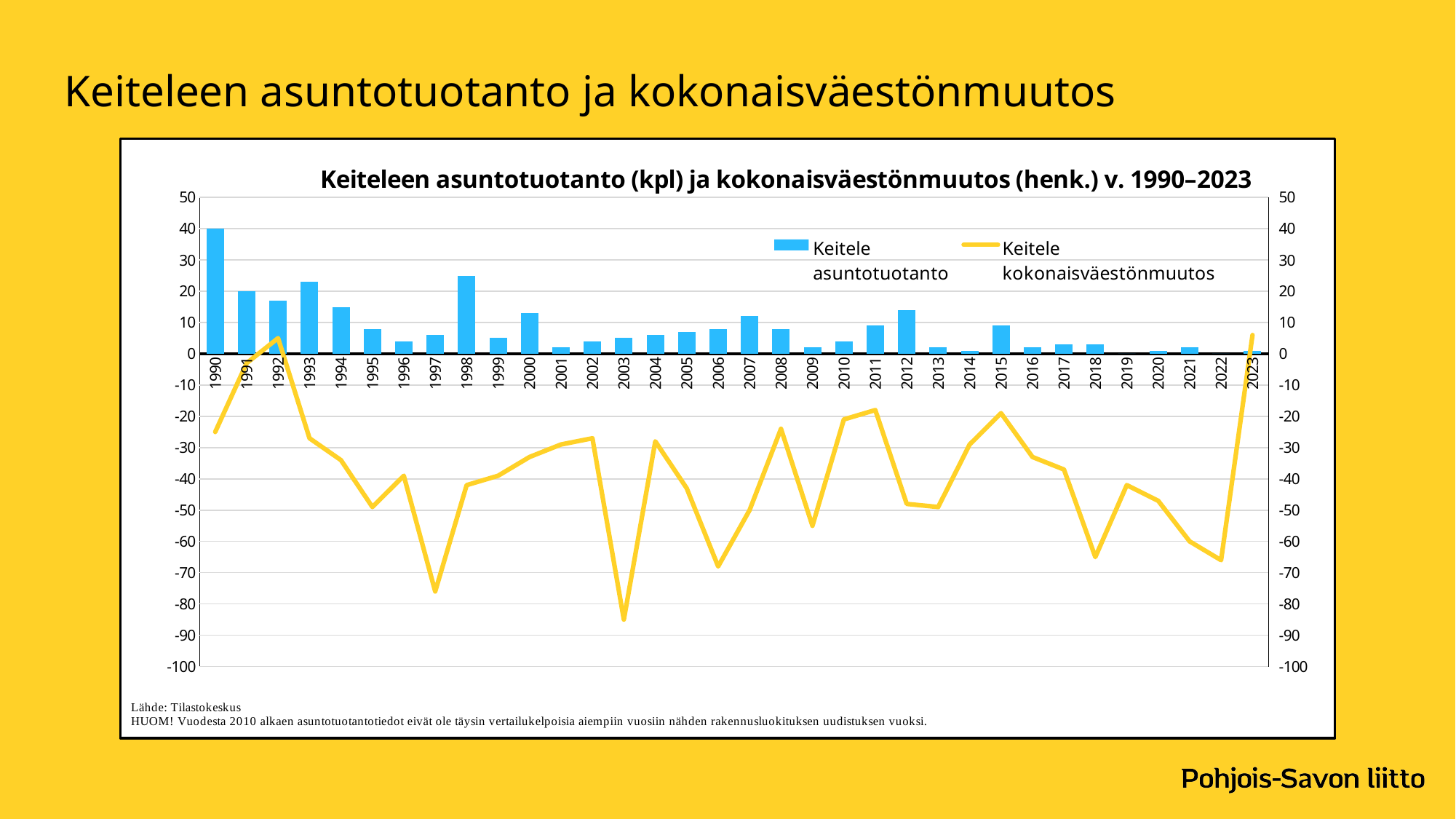
In which year does the Keitele kokonaisväestönmuutos line reach its lowest point? 2003 Which year has the highest bar for Keitele asuntotuotanto? 1990 Is the Keitele asuntotuotanto bar for 1998 greater or less than 20? greater How many series does the chart legend list? 2 Is the Keitele asuntotuotanto bar for 2012 greater or less than 10? greater What kind of chart is shown on the slide? A combined bar and line chart Is the Keitele kokonaisväestönmuutos value for 2003 greater or less than -80? less What colour is the Keitele kokonaisväestönmuutos line? Yellow How many years are shown on the x axis of the chart? 34 Which year has the larger Keitele asuntotuotanto bar, 1993 or 1994? 1993 Which year has the higher Keitele kokonaisväestönmuutos value, 1996 or 1997? 1996